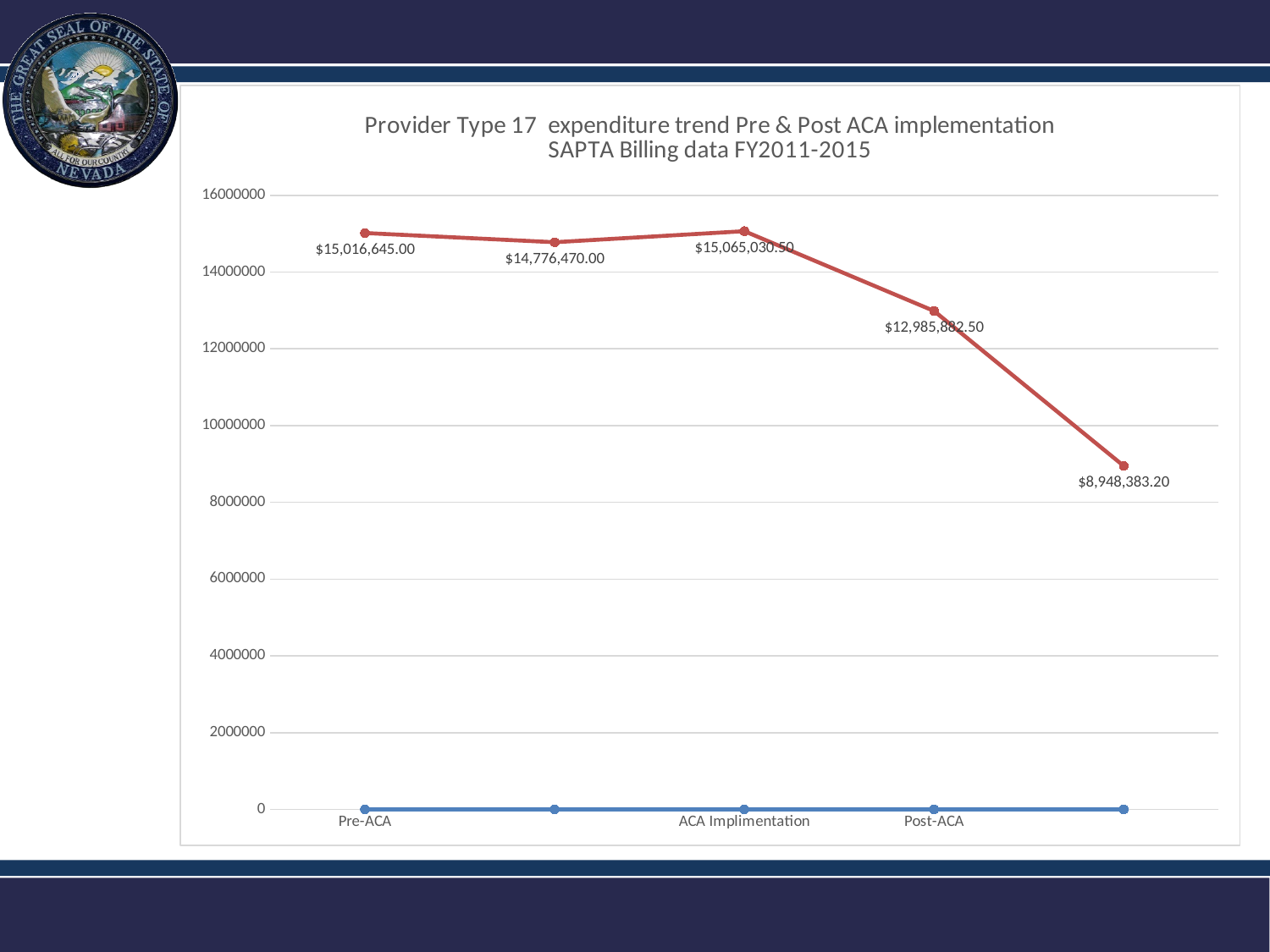
What is the title of the chart? Provider Type 17 expenditure trend Pre & Post ACA implementation SAPTA Billing data FY2011-2015 How many data points are plotted on the red line? 5 Is the value for Post-ACA greater or less than 12000000? greater Which has the higher expenditure, Pre-ACA or Post-ACA? Pre-ACA What is the expenditure value for Pre-ACA? $15,016,645.00 What kind of chart is shown on the slide? Line chart What is the lowest expenditure value labelled on the chart? $8,948,383.20 What is the expenditure value for ACA Implimentation? $15,065,030.50 Is the value for Pre-ACA greater or less than 14000000? greater What is the difference between the ACA Implimentation value and the Pre-ACA value? $48,385.50 Which has the higher expenditure, Pre-ACA or ACA Implimentation? ACA Implimentation Do the expenditure values rise or fall overall from left to right along the x axis? Fall